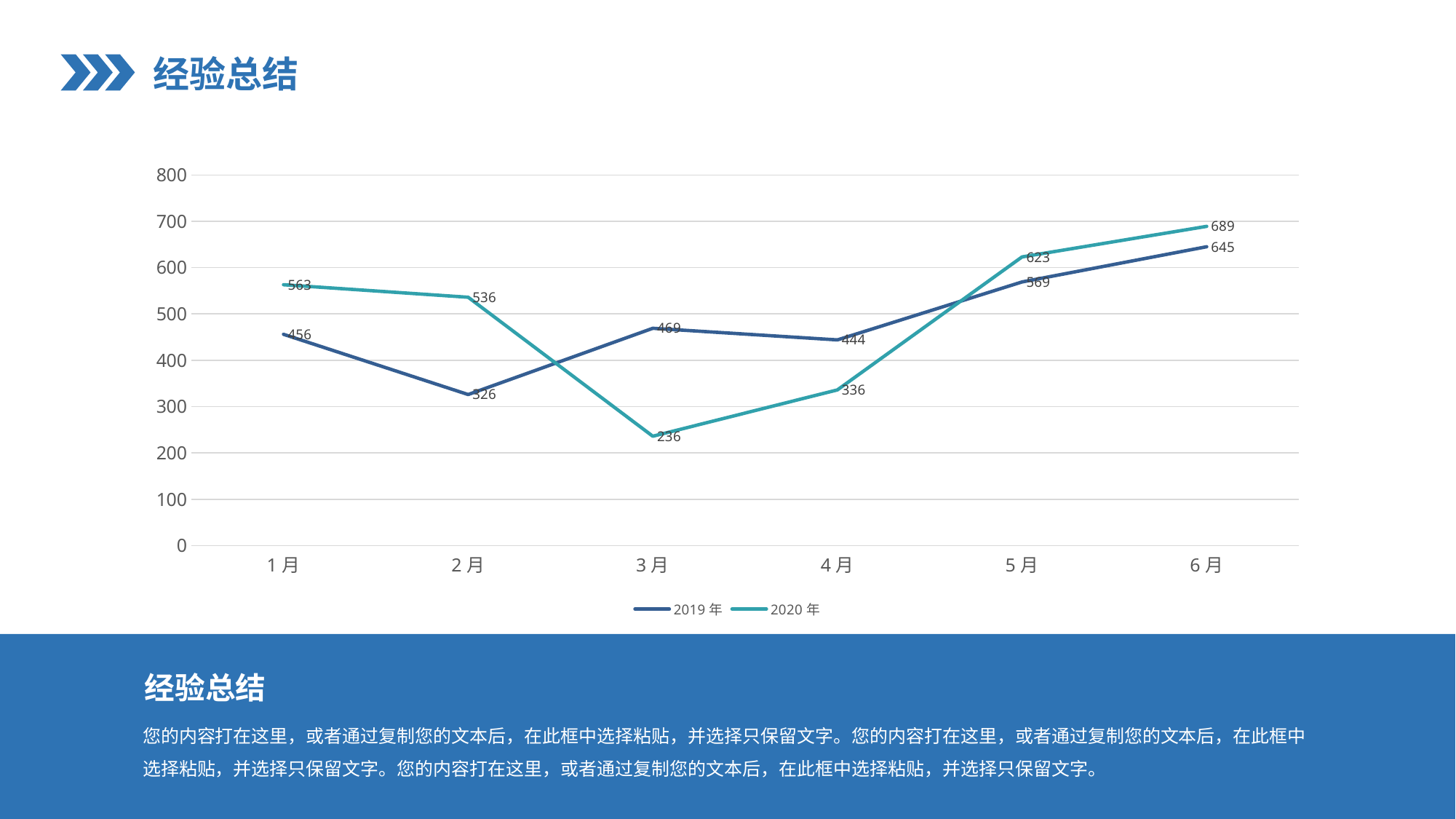
In which month is the 2020年 series highest? 6月 What is the difference between the 2020年 and 2019年 values in 6月? 44 What is the value for 2019年 in 3月? 469 What is the value for 2020年 in 3月? 236 How many months are plotted along the x axis? 6 In which month is the 2019年 series lowest? 2月 What type of chart is shown on the slide? line chart What is the difference between the 2019年 values in 1月 and 2月? 130 How many series does the legend list? 2 Which series has the larger value in 4月, 2019年 or 2020年? 2019年 What is the value for 2020年 in 6月? 689 Does the 2019年 series rise or fall from 4月 to 6月? rise